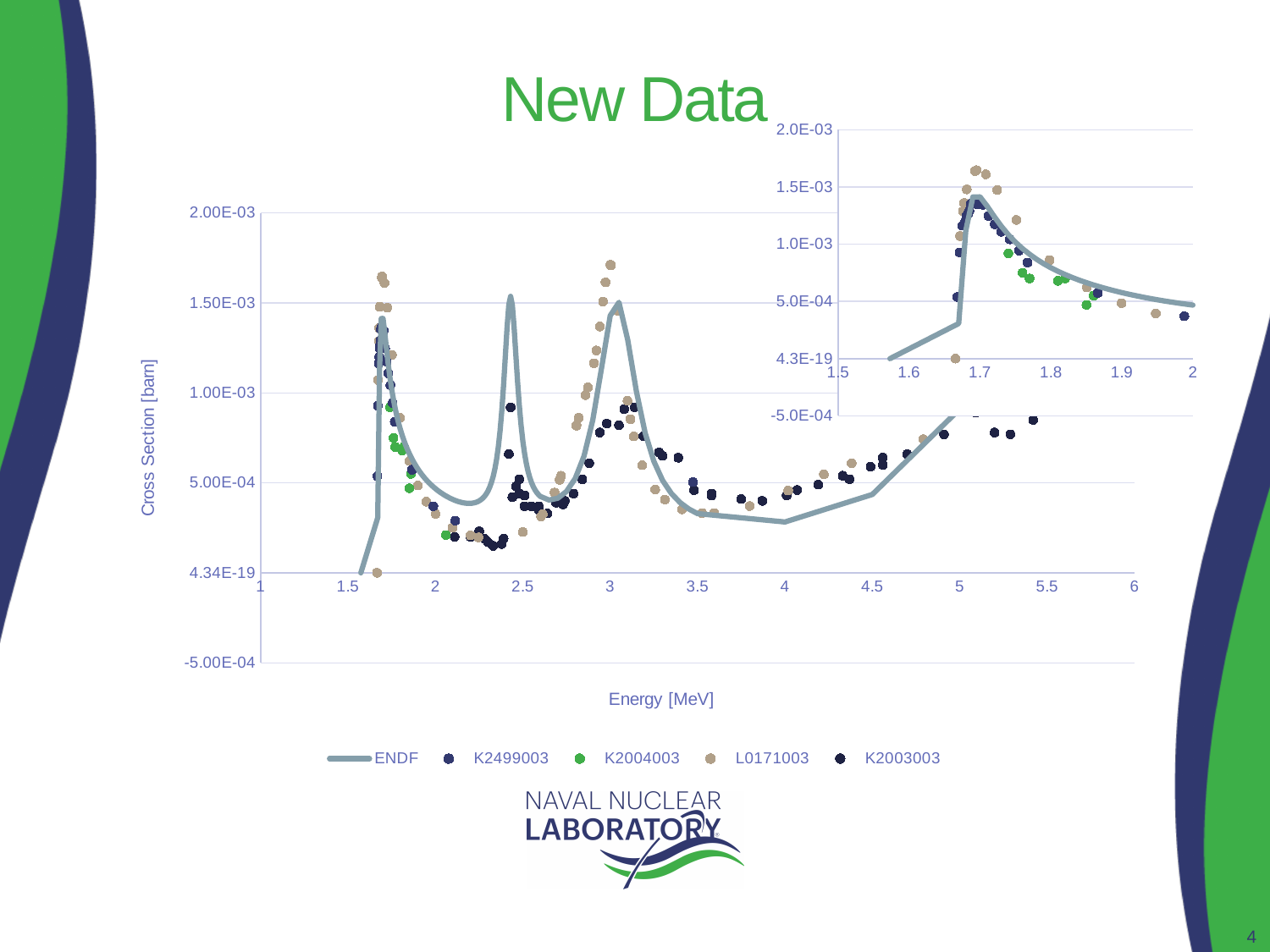
On the main chart, which series is drawn as a line rather than as points? ENDF On the main chart, is the ENDF peak near 1.7 MeV greater or less than 1.50E-03? less On the main chart, which series reaches the highest cross section value? L0171003 What kind of chart is the main chart on the slide? scatter chart On the main chart, how many peaks does the ENDF line show between 1.5 MeV and 3.5 MeV? 3 On the main chart, near 3 MeV, which is larger: the peak of the L0171003 points or the peak of the ENDF line? L0171003 On the main chart, is the ENDF value at 4 MeV greater or less than 5.00E-04? less On the main chart, is the highest L0171003 point near 3 MeV greater or less than 1.50E-03? greater On the main chart, does the ENDF line rise or fall between 4 MeV and 5 MeV? rise How many series does the legend of the main chart list? 5 On the main chart, what is the title of the x axis? Energy [MeV] On the main chart, does the ENDF line rise or fall between 3.1 MeV and 4 MeV? fall